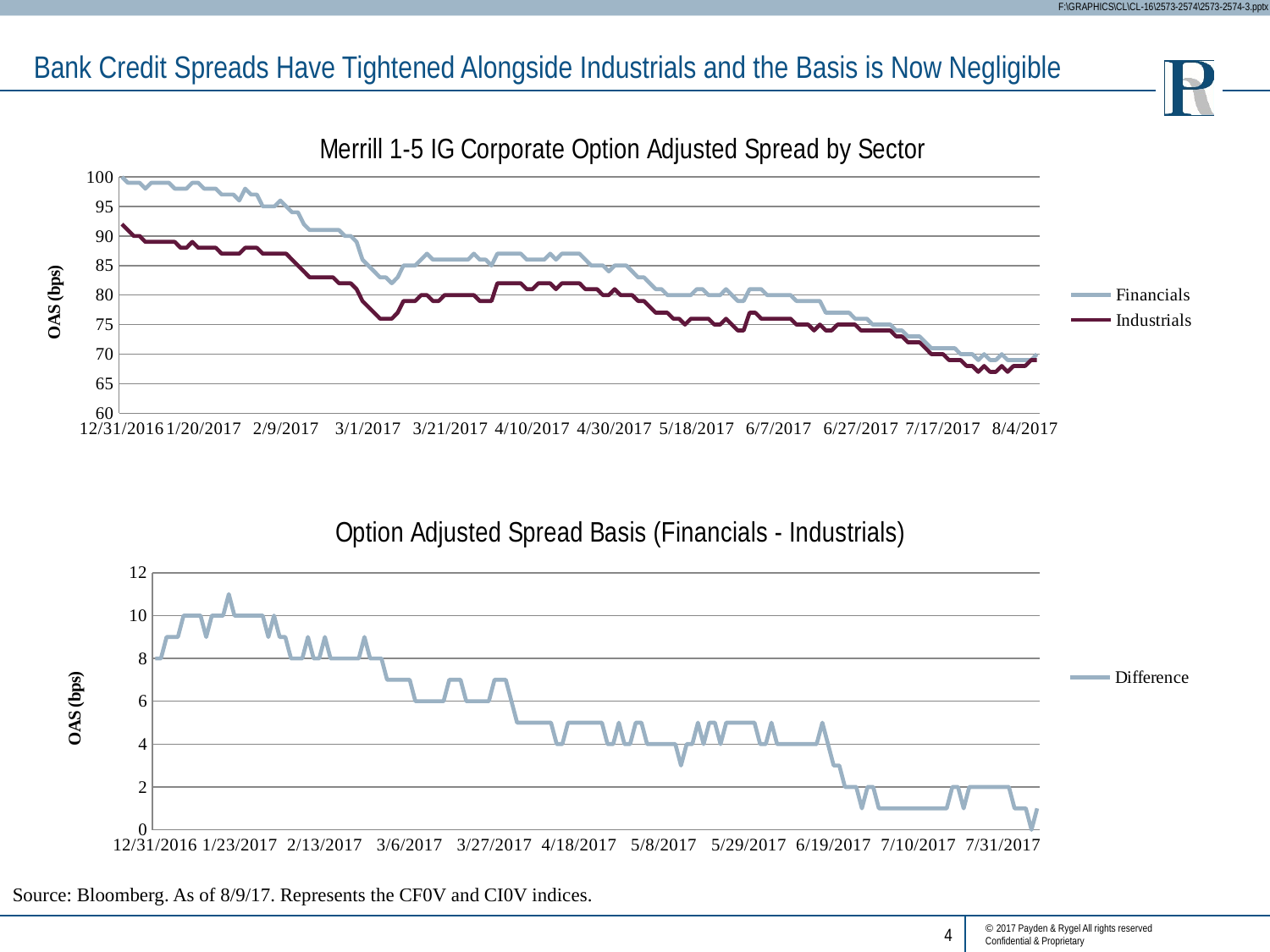
In the top chart, which series is higher at 12/31/2016, Financials or Industrials? Financials How many series does the legend of the bottom chart list? 1 What kind of chart is the top chart titled 'Merrill 1-5 IG Corporate Option Adjusted Spread by Sector'? Line chart In the bottom chart, does the Difference generally rise or fall from 12/31/2016 to 7/31/2017? Fall In the bottom chart, is the Difference value at 12/31/2016 greater or less than 6? greater In the top chart, is the Industrials value at 12/31/2016 greater or less than 85? greater What is the y-axis label of the top chart? OAS (bps) In the top chart, is the Financials value at 8/4/2017 greater or less than 75? less What is the title of the bottom chart? Option Adjusted Spread Basis (Financials - Industrials) In the top chart, do the Financials values generally rise or fall from 12/31/2016 to 8/4/2017? Fall How many series does the legend of the top chart list? 2